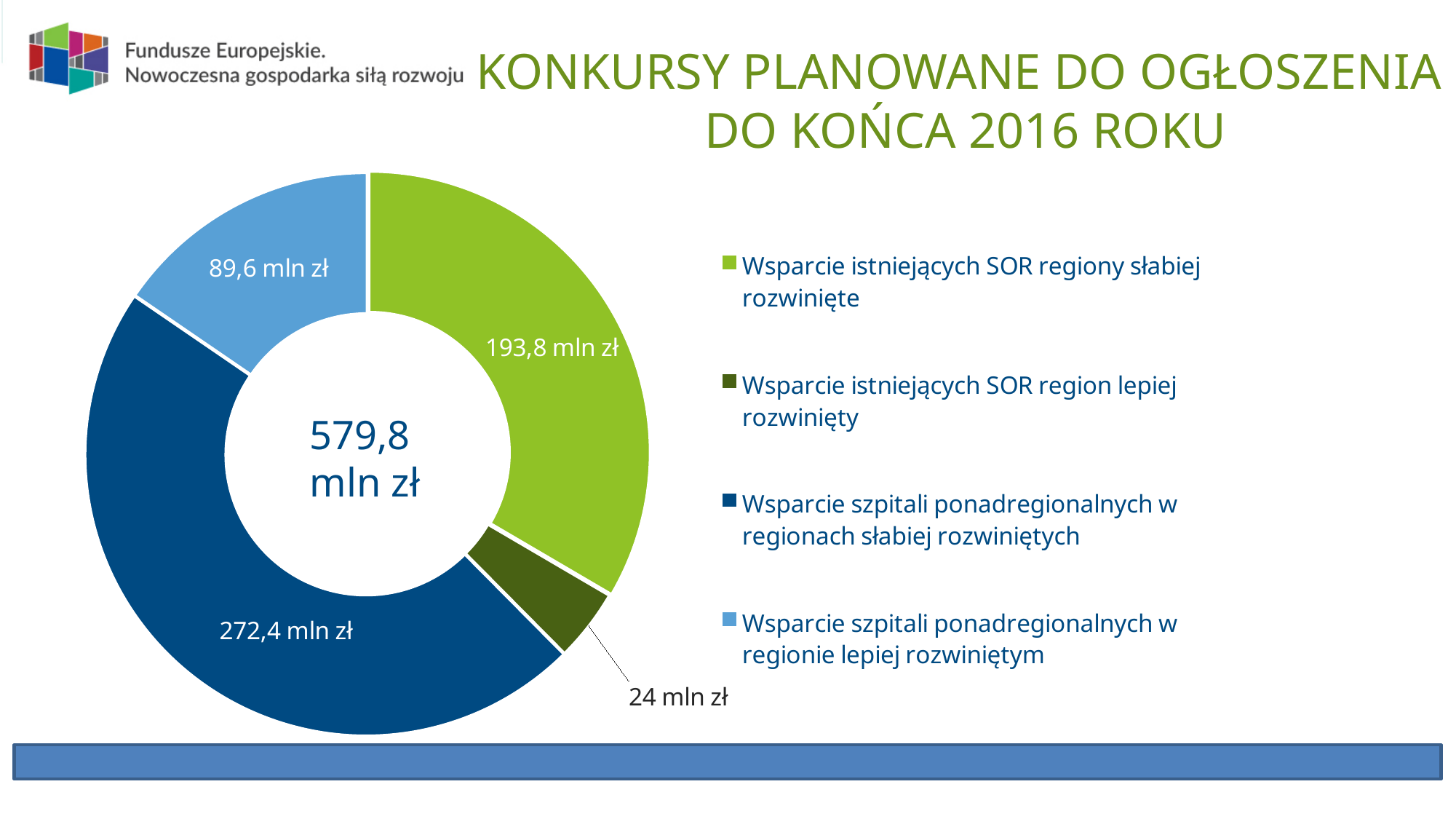
How many categories does the chart show? 4 What value is shown for 'Wsparcie istniejących SOR regiony słabiej rozwinięte'? 193,8 mln zł What is the difference between the value for 'Wsparcie szpitali ponadregionalnych w regionie lepiej rozwiniętym' and the value for 'Wsparcie istniejących SOR region lepiej rozwinięty'? 65,6 mln zł What value is shown for 'Wsparcie istniejących SOR region lepiej rozwinięty'? 24 mln zł What value is shown for 'Wsparcie szpitali ponadregionalnych w regionie lepiej rozwiniętym'? 89,6 mln zł What total value is shown in the centre of the chart? 579,8 mln zł What is the difference between the value for 'Wsparcie szpitali ponadregionalnych w regionach słabiej rozwiniętych' and the value for 'Wsparcie istniejących SOR regiony słabiej rozwinięte'? 78,6 mln zł What value is shown for 'Wsparcie szpitali ponadregionalnych w regionach słabiej rozwiniętych'? 272,4 mln zł Which category has the largest slice of the chart? Wsparcie szpitali ponadregionalnych w regionach słabiej rozwiniętych Which category has the smallest slice of the chart? Wsparcie istniejących SOR region lepiej rozwinięty Which is larger: the value for 'Wsparcie istniejących SOR regiony słabiej rozwinięte' or the value for 'Wsparcie szpitali ponadregionalnych w regionie lepiej rozwiniętym'? Wsparcie istniejących SOR regiony słabiej rozwinięte What kind of chart is shown on the slide? Donut (pie) chart